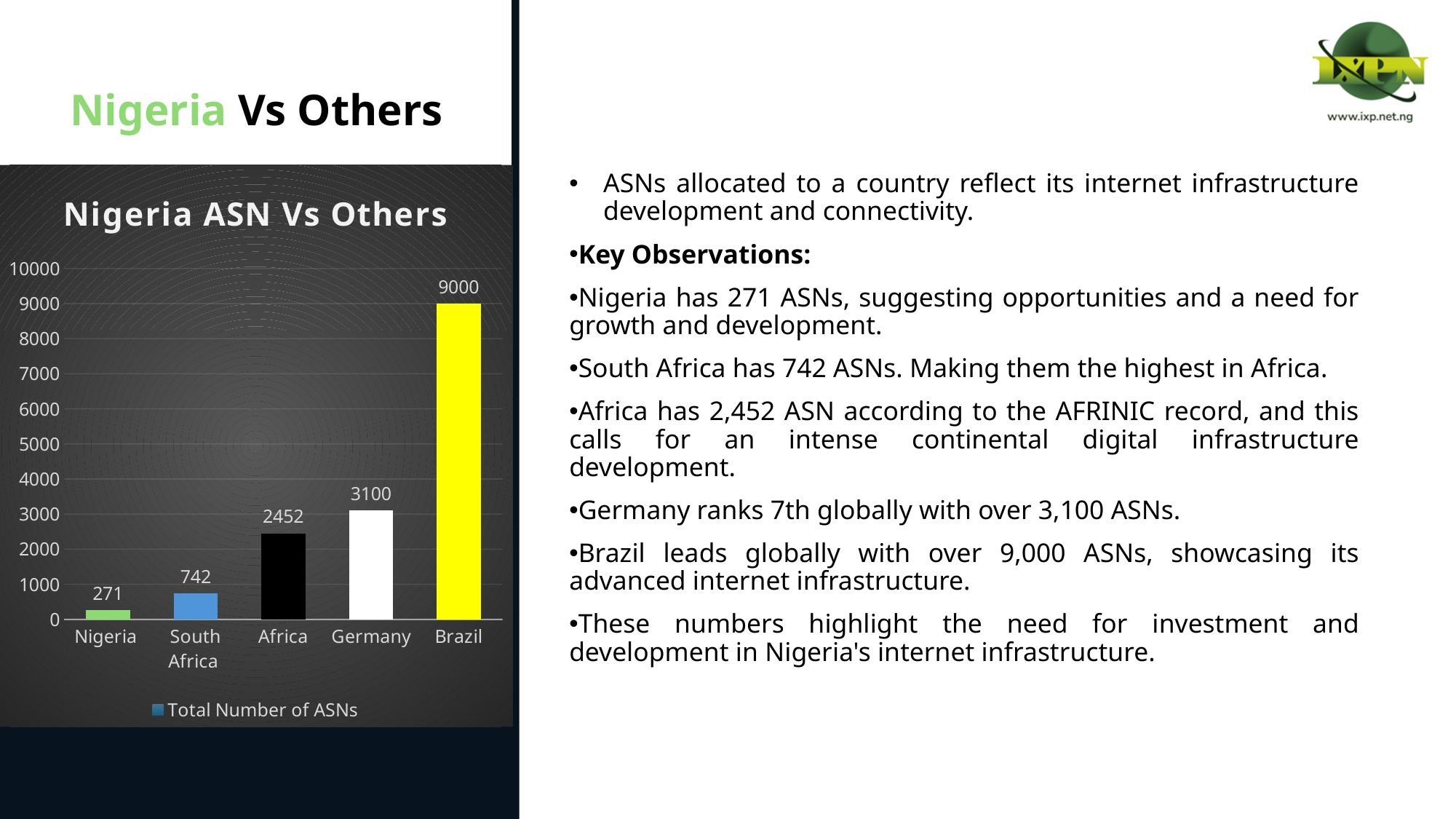
How many categories are shown on the x axis of the chart? 5 What is the difference between the values for Africa and South Africa? 1710 Which category has the lowest value in the chart? Nigeria Is the value for Brazil greater or less than 8000? greater Which category has the highest value in the chart? Brazil What is the difference between the values for Brazil and Germany? 5900 What is the value for South Africa in the chart? 742 Which is larger, the value for Africa or the value for Germany? Germany What is the value for Nigeria in the Nigeria ASN Vs Others chart? 271 What kind of chart is shown on the slide? Bar chart What is the legend entry shown below the chart? Total Number of ASNs What is the value for Germany in the chart? 3100